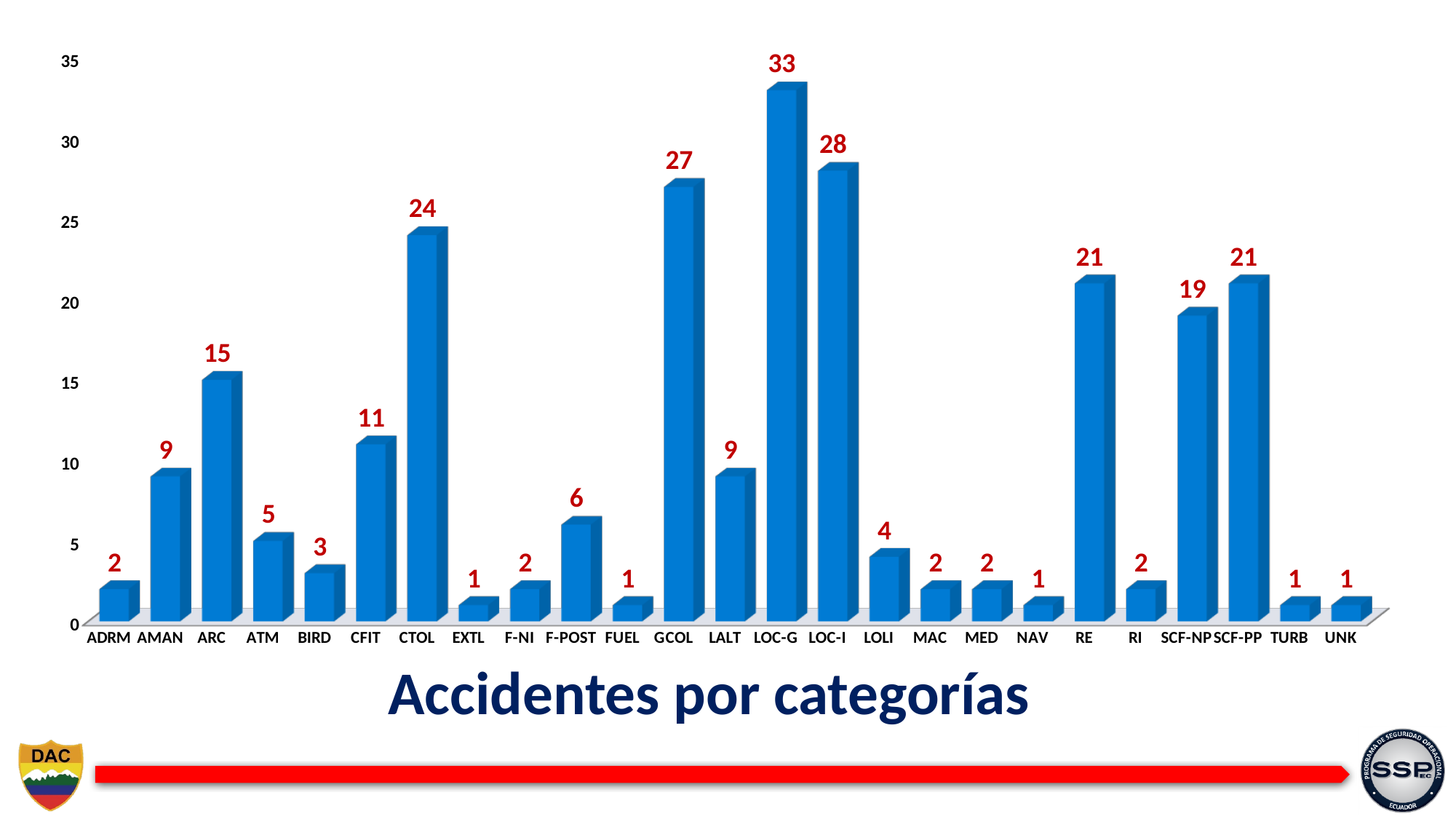
Which is larger, the value for ARC or the value for AMAN? ARC What kind of chart is shown on the slide? Bar chart How many categories are shown on the x axis? 25 What is the value for LOC-G? 33 Which is larger, the value for RE or the value for SCF-NP? RE What is the difference between the values for GCOL and CFIT? 16 What is the title of the chart? Accidentes por categorías Which category has the highest value? LOC-G What is the value for CTOL? 24 What is the difference between the values for LOC-G and LOC-I? 5 What is the value for SCF-NP? 19 What is the value for F-POST? 6